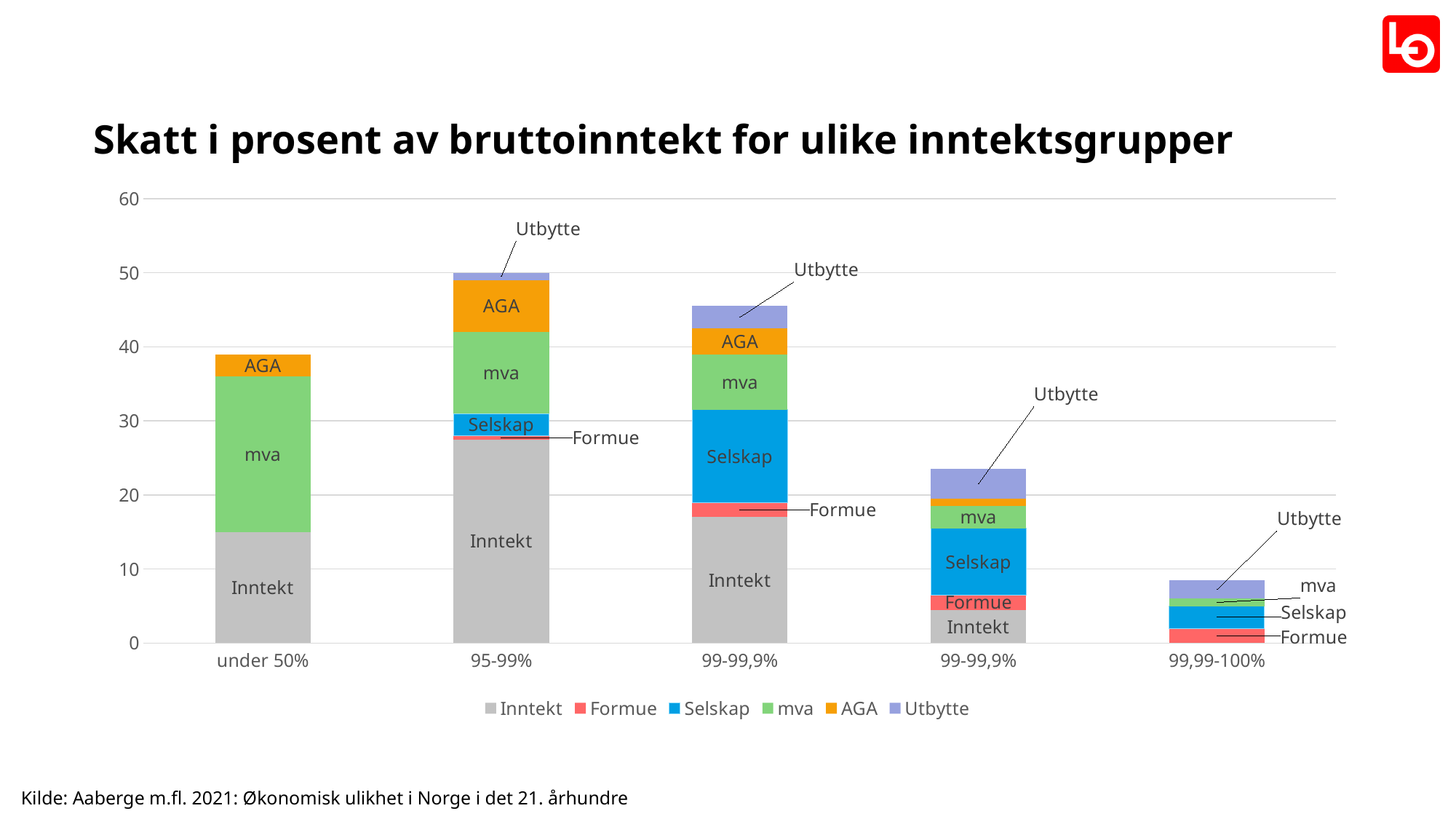
Which is larger, the total bar for 'under 50%' or the total bar for '99,99-100%'? under 50% From the second bar (95-99%) to the last bar (99,99-100%), do the total bar heights rise or fall? fall Which income group has the highest total tax share (tallest stacked bar)? 95-99% Is the total stacked bar for '99,99-100%' greater or less than 10? less How many income groups (bars) are shown on the x axis? 5 Is the Inntekt segment for '95-99%' greater or less than 20? greater What is the title of the chart? Skatt i prosent av bruttoinntekt for ulike inntektsgrupper What kind of chart is shown on the slide? Stacked bar chart Which income group has the lowest total tax share (shortest stacked bar)? 99,99-100% Is the Inntekt segment for 'under 50%' greater or less than 10? greater How many series does the legend list? 6